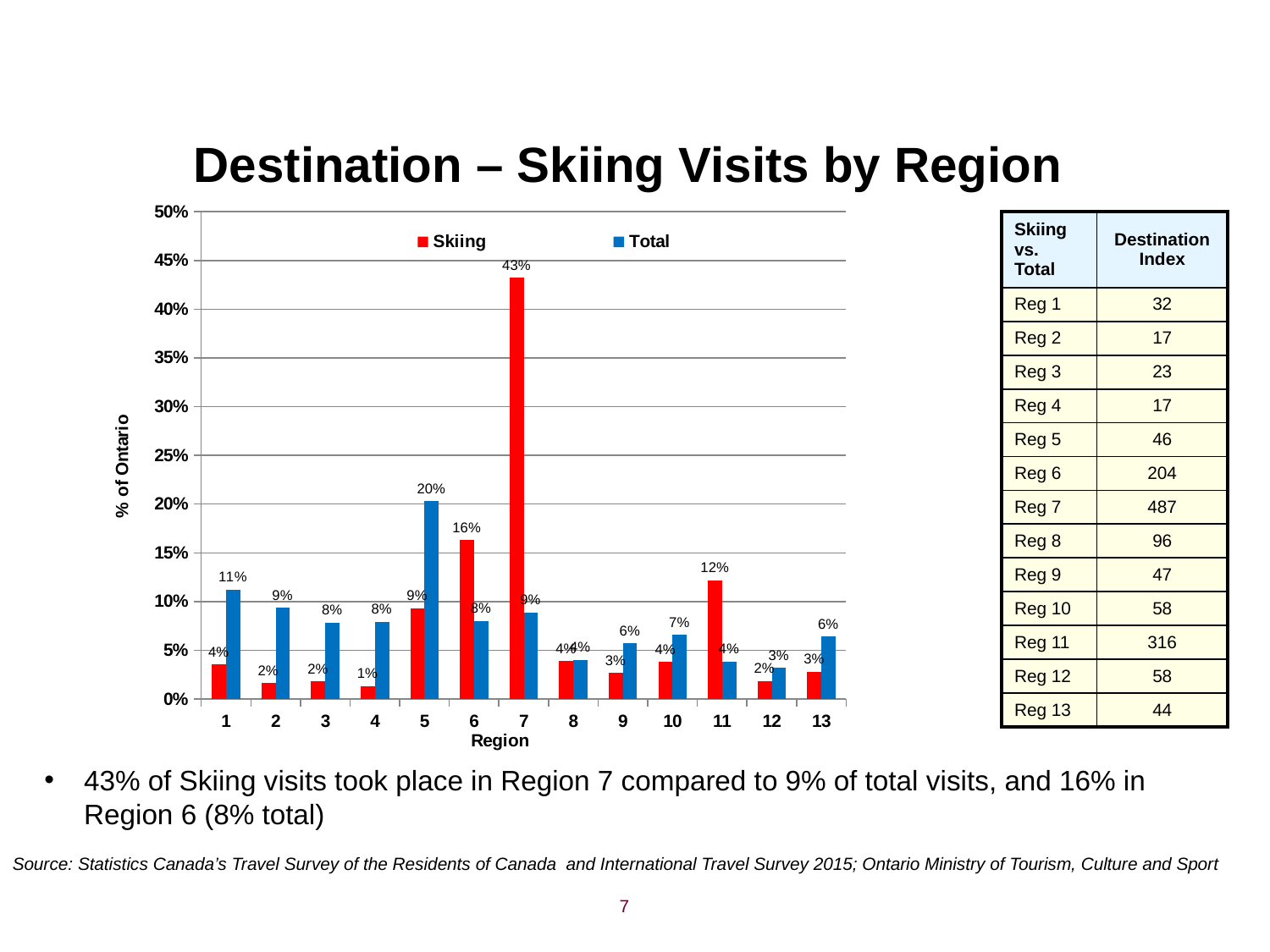
What type of chart is shown on the slide? Bar chart Which is larger for Region 6, the Skiing value or the Total value? Skiing What is the Skiing value for Region 11? 12% How many series does the legend list? 2 What is the difference between the Skiing and Total values for Region 7? 34% What is the Total value for Region 1? 11% Which region has the highest Skiing value? Region 7 How many regions are shown on the x axis? 13 What is the Skiing value for Region 7? 43% Which region has the highest Total value? Region 5 Which region has the lowest Skiing value? Region 4 What is the Total value for Region 5? 20%